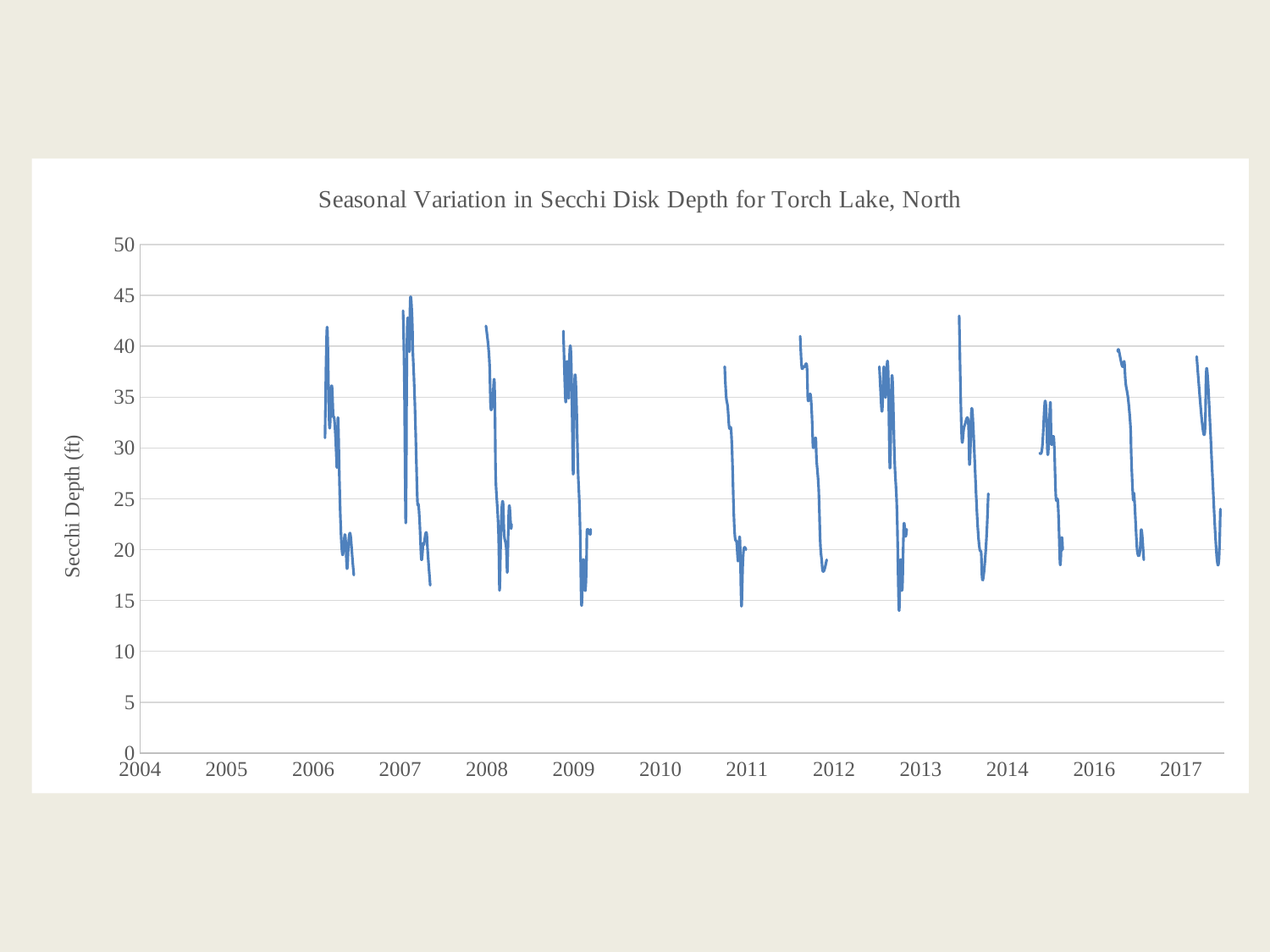
Within each season, do the Secchi depth values generally rise or fall as the season progresses? fall What is the label on the vertical axis of the chart? Secchi Depth (ft) Is the highest Secchi depth value in the 2010 season greater or less than 40? less How many year labels are shown on the horizontal axis? 13 What is the maximum value shown on the vertical axis? 50 Is the highest Secchi depth value recorded in the 2007 season greater or less than 40? greater Is the lowest Secchi depth value in the 2016 season greater or less than 25? less What kind of chart is shown on the slide? line chart What is the title of the chart? Seasonal Variation in Secchi Disk Depth for Torch Lake, North